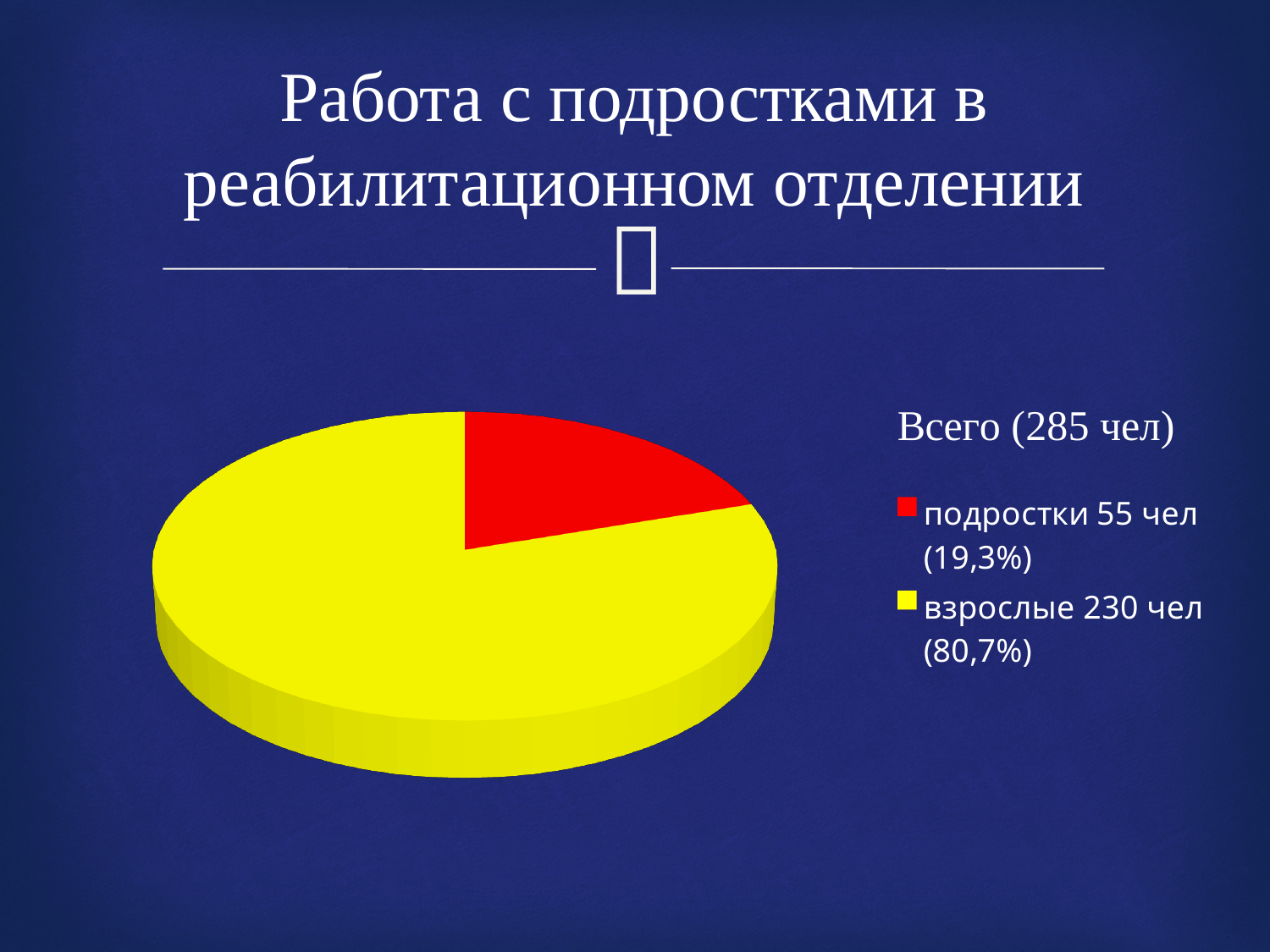
Which category has the smallest slice? подростки What share of the pie does the взрослые slice represent? 80,7% What colour is the подростки slice? red How many people are in the подростки category? 55 чел What kind of chart is shown on the slide? pie chart How many slices does the pie chart have? 2 How many entries does the legend list? 2 What is the total number of people shown in the chart? 285 чел Which category has the largest slice? взрослые What share of the pie does the подростки slice represent? 19,3% What is the difference in number of people between взрослые and подростки? 175 чел How many people are in the взрослые category? 230 чел